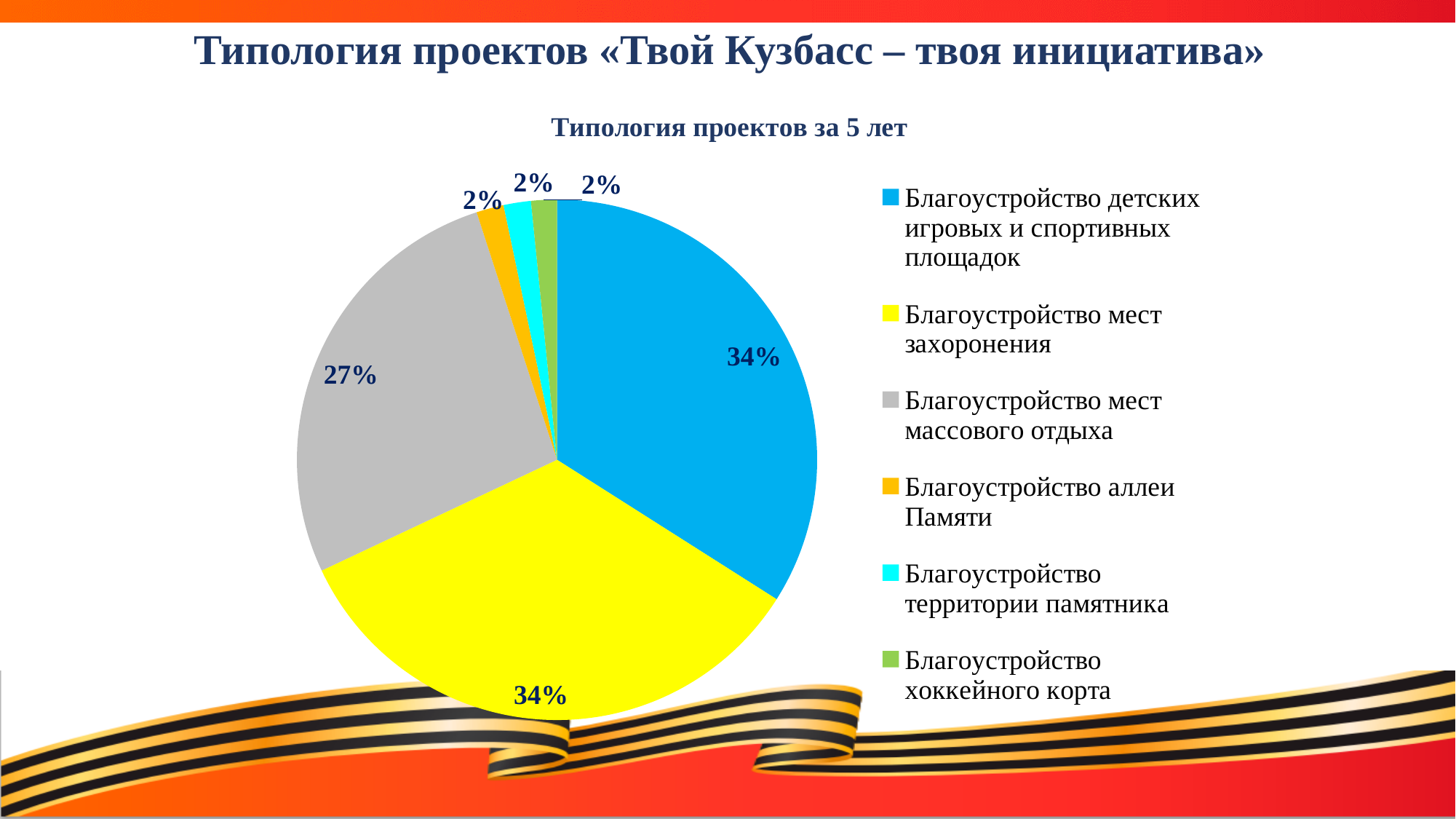
What share of the pie is "Благоустройство мест захоронения"? 34% What is the difference between the shares of "Благоустройство детских игровых и спортивных площадок" and "Благоустройство аллеи Памяти"? 32% What share of the pie is "Благоустройство детских игровых и спортивных площадок"? 34% What kind of chart is shown on the slide? pie chart Which is larger: "Благоустройство мест массового отдыха" or "Благоустройство территории памятника"? Благоустройство мест массового отдыха What share of the pie is "Благоустройство хоккейного корта"? 2% What is the chart's title? Типология проектов за 5 лет How many categories does the pie chart have? 6 Which colour represents "Благоустройство мест захоронения" in the legend? yellow What is the difference between the shares of "Благоустройство мест захоронения" and "Благоустройство мест массового отдыха"? 7%